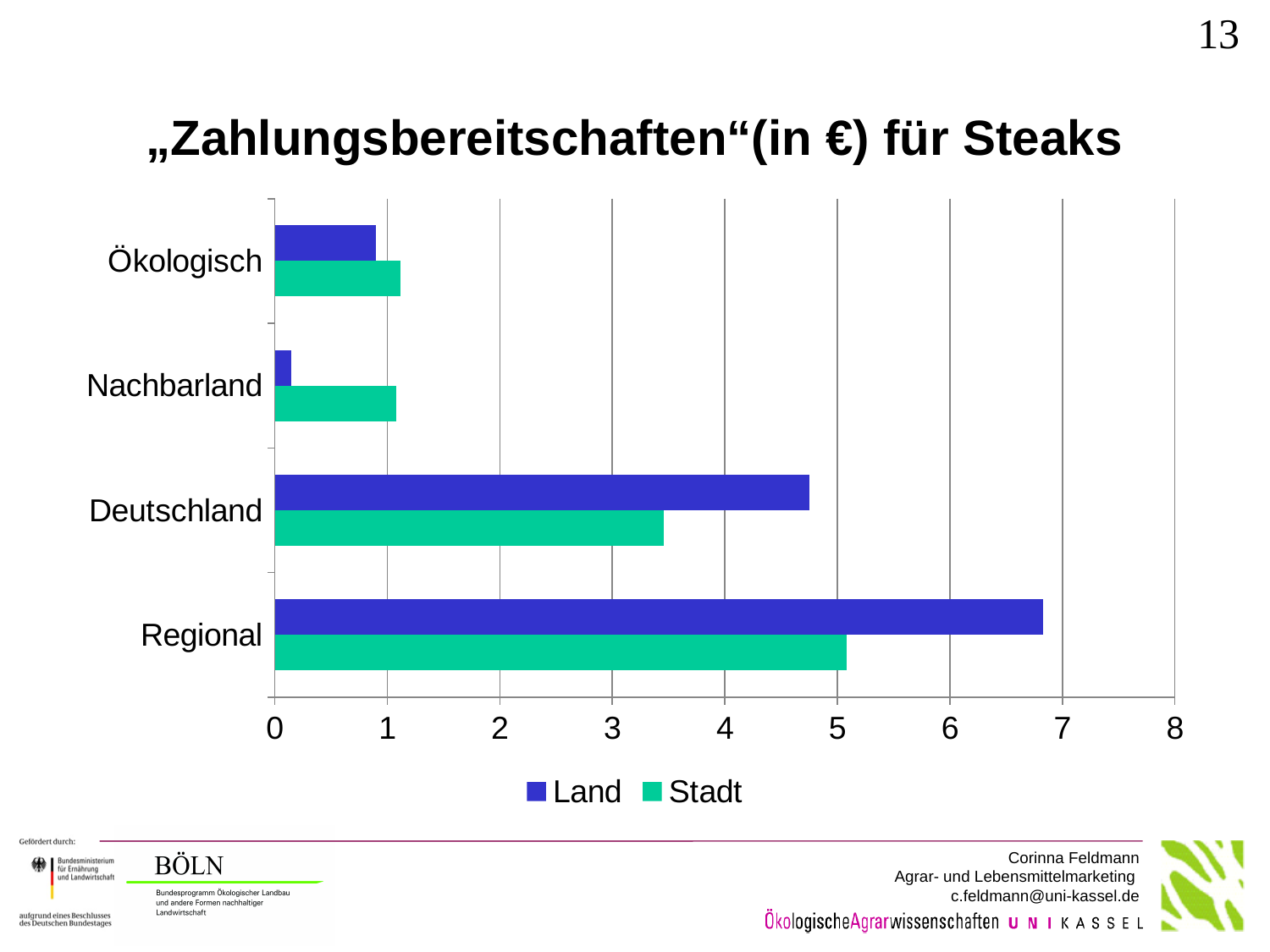
Is the Land value for Nachbarland greater or less than 1? less For Deutschland, which series has the larger value, Land or Stadt? Land What kind of chart is shown on the slide? bar chart What is the title of the chart? „Zahlungsbereitschaften“(in €) für Steaks Which category has the lowest value for the Land series? Nachbarland Is the Land value for Regional greater or less than 6? greater For Nachbarland, which series has the larger value, Land or Stadt? Stadt How many categories are shown on the chart? 4 How many series does the legend list? 2 Is the Stadt value for Deutschland greater or less than 4? less Which category has the highest value for the Land series? Regional Which category has the highest value for the Stadt series? Regional